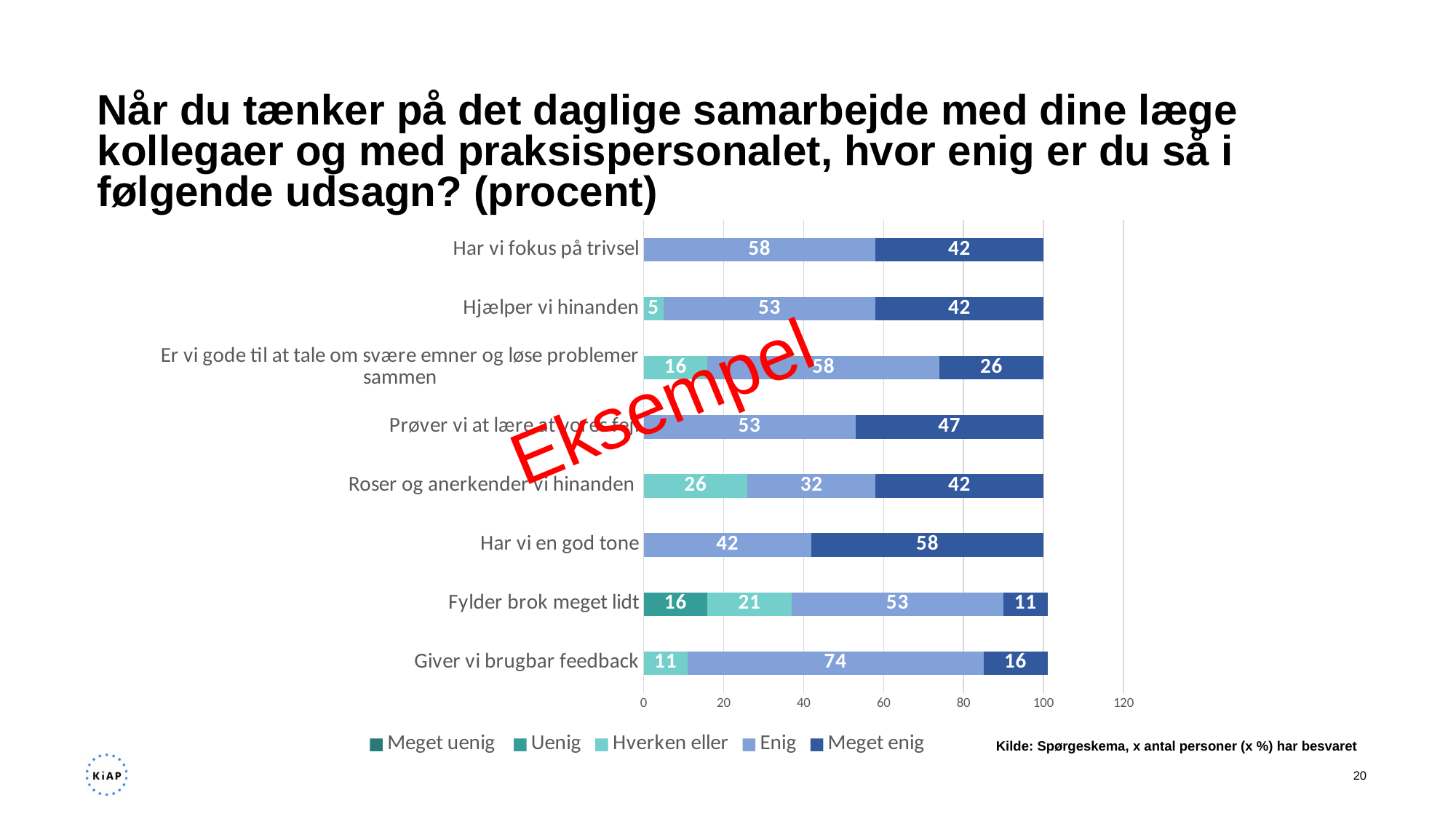
What is the total of the stacked bar for "Fylder brok meget lidt"? 101 What is the value of "Hverken eller" for "Roser og anerkender vi hinanden"? 26 What is the difference between the "Enig" value for "Giver vi brugbar feedback" and the "Enig" value for "Har vi en god tone"? 32 Which category has the highest "Meget enig" value? Har vi en god tone How many categories (statements) are shown in the chart? 8 How many series does the legend list? 5 Which is larger: the "Meget enig" value for "Har vi fokus på trivsel" or the "Meget enig" value for "Er vi gode til at tale om svære emner og løse problemer sammen"? Har vi fokus på trivsel What is the value of "Uenig" for "Fylder brok meget lidt"? 16 What is the value of "Enig" for "Giver vi brugbar feedback"? 74 What is the value of "Meget enig" for "Har vi en god tone"? 58 Which category has the lowest "Meget enig" value? Fylder brok meget lidt What kind of chart is shown on the slide? Stacked bar chart